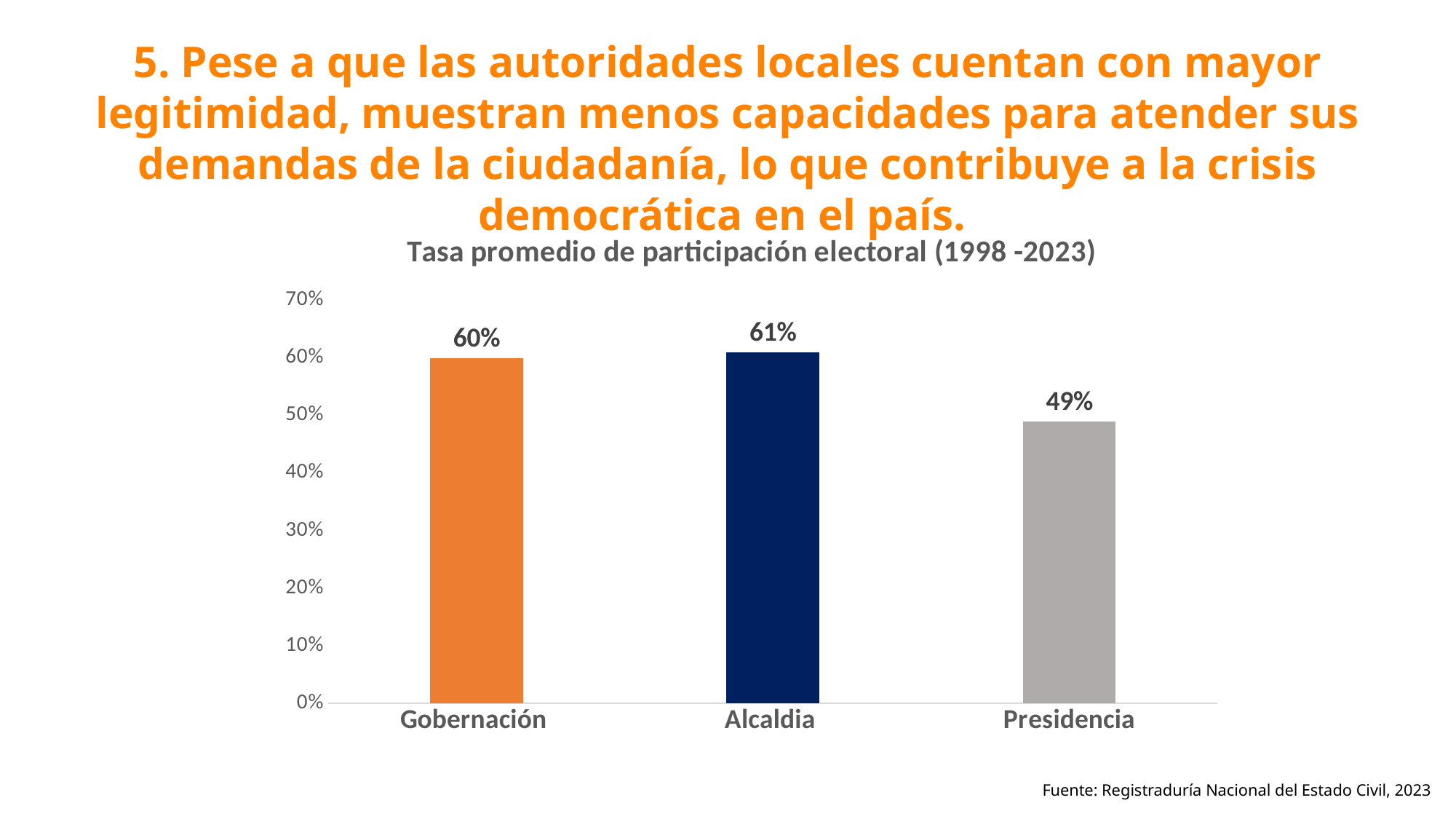
Which is larger, the value for Gobernación or the value for Presidencia? Gobernación What is the difference between the values for Gobernación and Presidencia? 11% Is the value for Alcaldia greater or less than 60%? greater What is the value for Gobernación? 60% What kind of chart is shown on the slide? bar chart What is the value for Alcaldia? 61% What is the value for Presidencia? 49% What is the title of the chart? Tasa promedio de participación electoral (1998 -2023) Is the value for Presidencia greater or less than 50%? less What is the difference between the values for Alcaldia and Presidencia? 12% How many categories are shown on the chart? 3 Which category has the lowest value? Presidencia